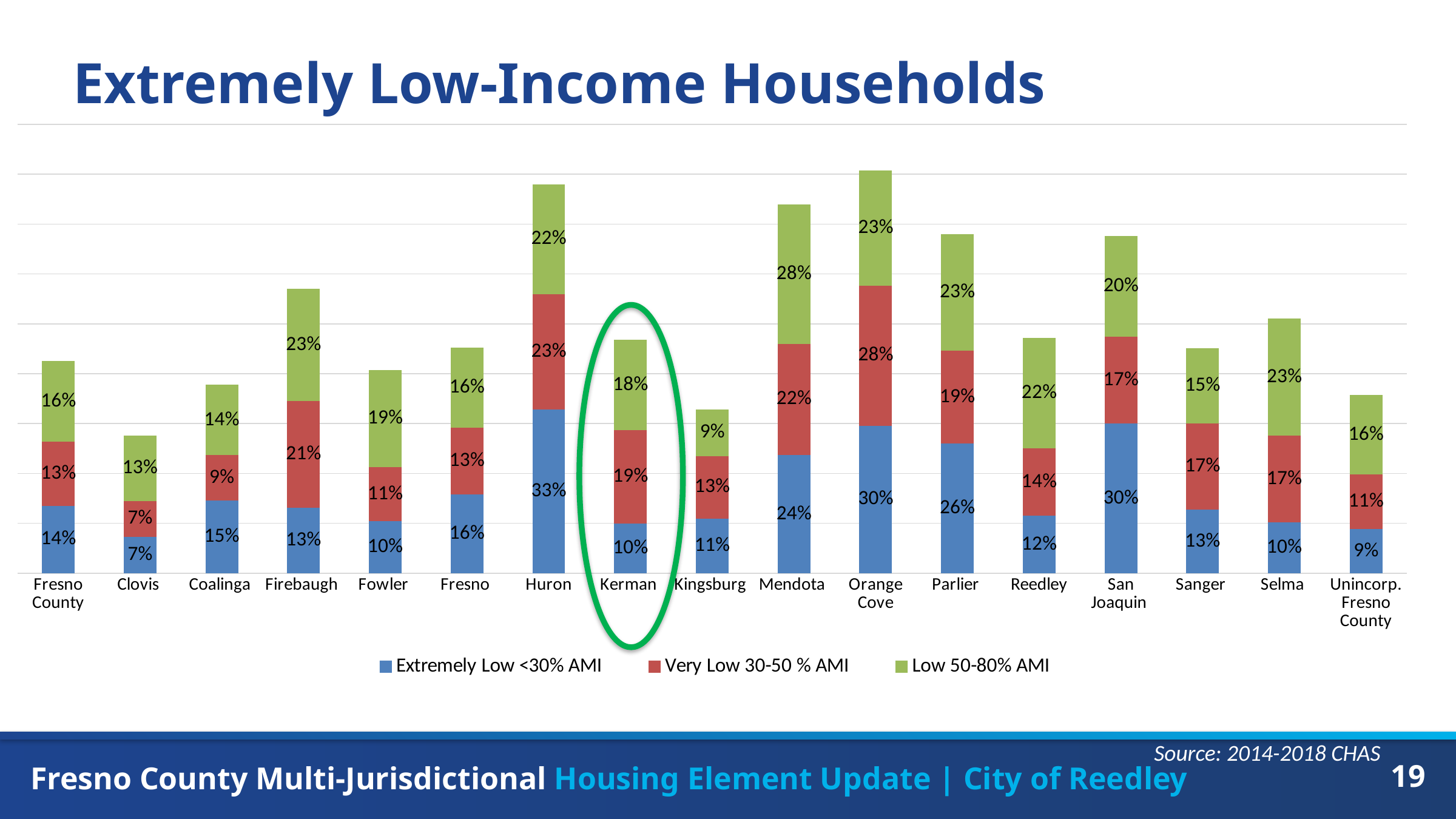
What is the difference between the Low 50-80% AMI values for Mendota and Kingsburg? 19% What is the Extremely Low <30% AMI value for Huron? 33% How many series does the legend list? 3 How many jurisdictions (categories) are shown on the x axis? 17 Which jurisdiction on the chart is circled in green? Kerman What is the total of the three stacked segments for Kerman? 47% What is the Low 50-80% AMI value for Reedley? 22% Which jurisdiction has the lowest Extremely Low <30% AMI value? Clovis Which is larger, the Very Low 30-50 % AMI value for Firebaugh or for Fowler? Firebaugh What kind of chart is shown on the slide? Stacked bar chart Which jurisdiction has the highest Extremely Low <30% AMI value? Huron What is the Very Low 30-50 % AMI value for Kerman? 19%